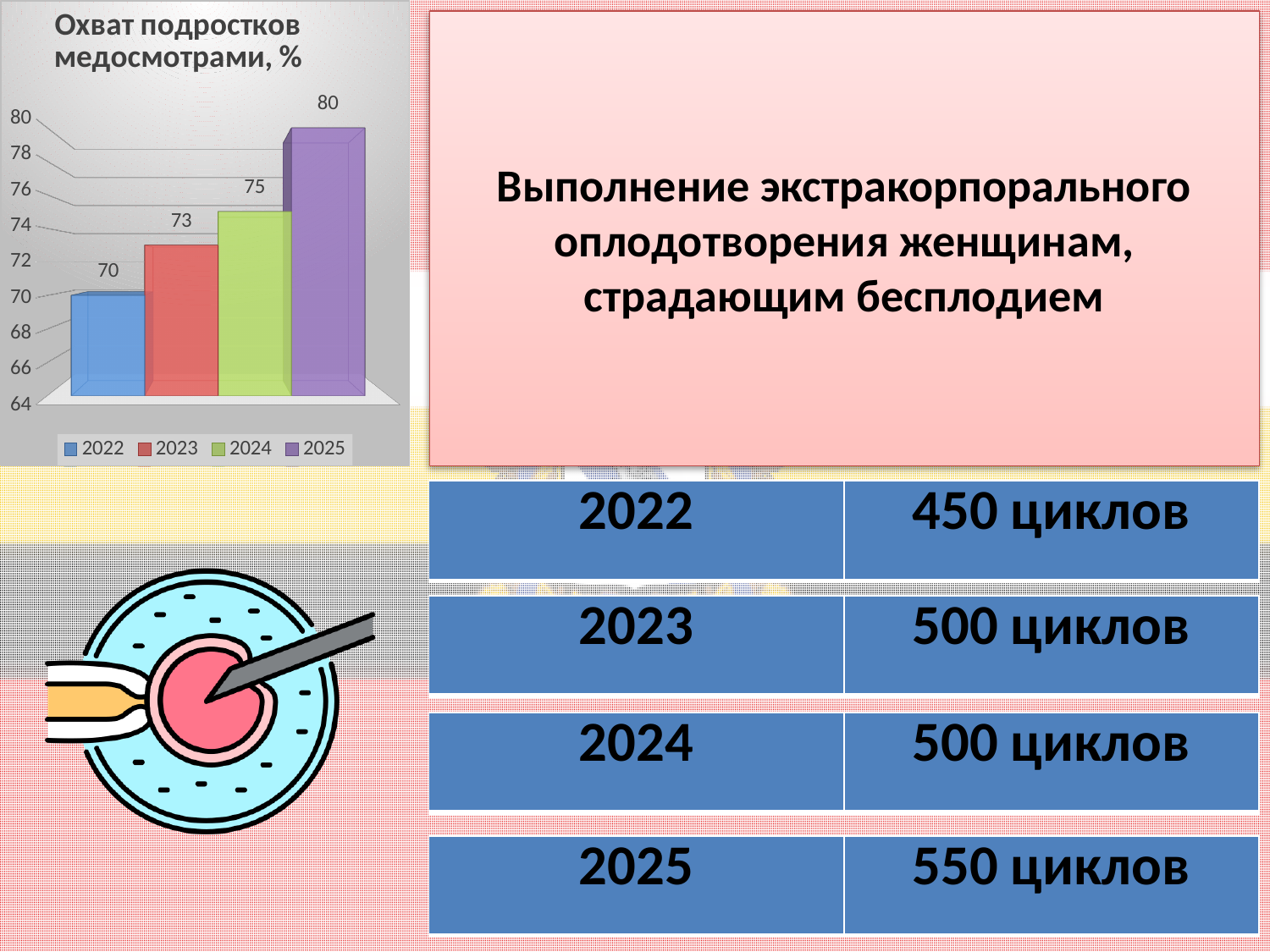
How many bars are plotted in the chart? 4 Which year has the highest value in the chart? 2025 Which is larger, the value for 2023 or the value for 2024? 2024 How many entries does the chart legend list? 4 What is the difference between the values for 2025 and 2022? 10 What is the value for 2022 in the chart? 70 What kind of chart is shown on the slide? bar chart What is the value for 2023 in the chart? 73 Which year has the lowest value in the chart? 2022 What is the value for 2025 in the chart? 80 Do the values rise or fall from 2022 to 2025? rise What is the value for 2024 in the chart? 75